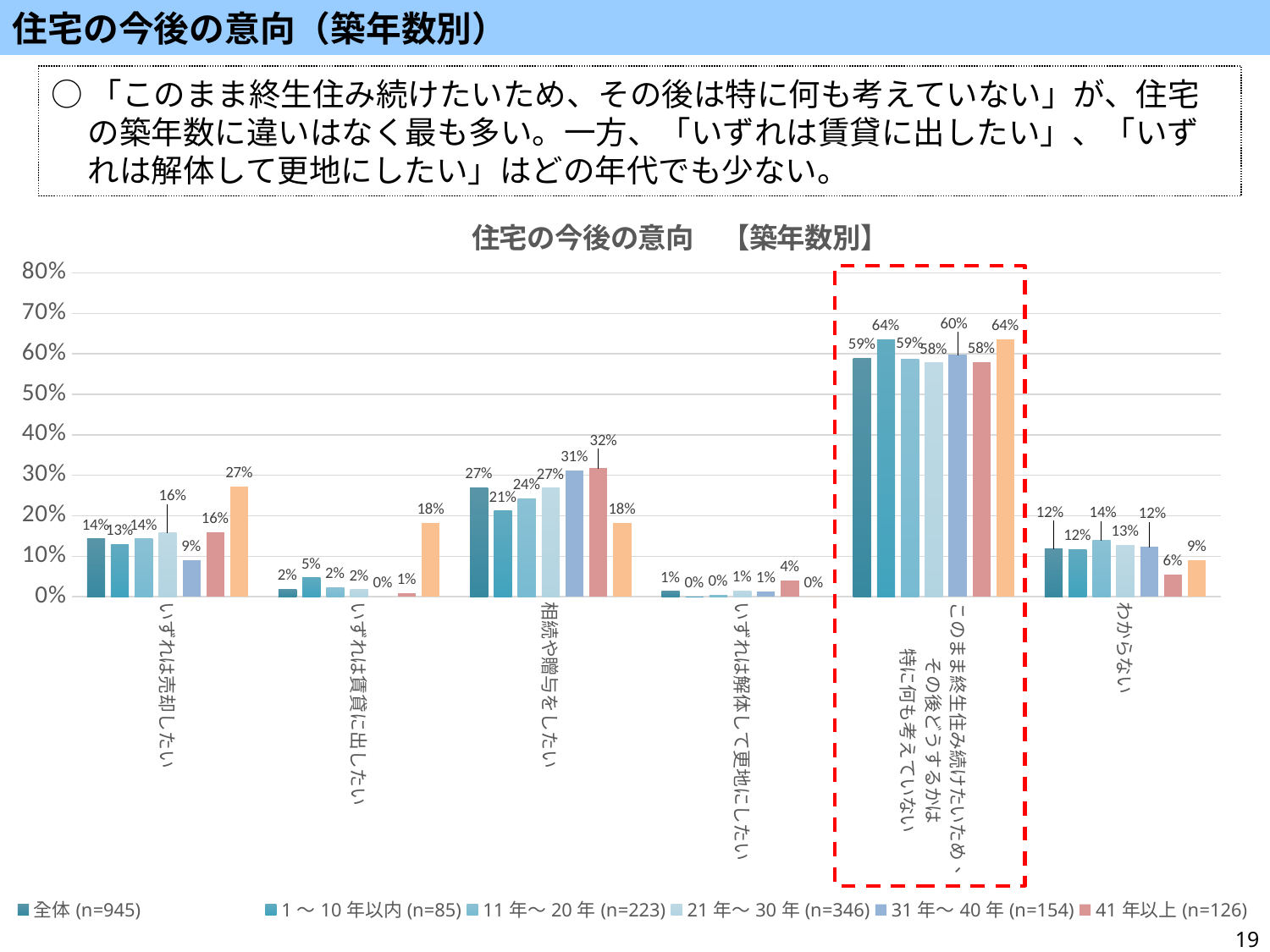
For the 全体 (n=945) series, which category has the lowest value? いずれは解体して更地にしたい In the 相続や贈与をしたい category, what is the difference between the 31 年～40 年 value and the 1～10 年以内 value? 10 percentage points What is the value for 31 年～40 年 (n=154) in the いずれは売却したい category? 9% Is the 全体 value for このまま終生住み続けたいため、その後どうするかは特に何も考えていない greater or less than 50%? greater For the 全体 (n=945) series, which category has the highest value? このまま終生住み続けたいため、その後どうするかは特に何も考えていない What is the value for 全体 (n=945) in the 相続や贈与をしたい category? 27% In the 相続や贈与をしたい category, which is larger: the 41 年以上 value or the 全体 value? 41 年以上 What is the value for 1～10 年以内 (n=85) in the このまま終生住み続けたいため、その後どうするかは特に何も考えていない category? 64% How many series does the legend list? 6 What kind of chart is shown on the slide? bar chart What is the value for 41 年以上 (n=126) in the いずれは解体して更地にしたい category? 4% How many categories are shown on the x axis of the chart? 6